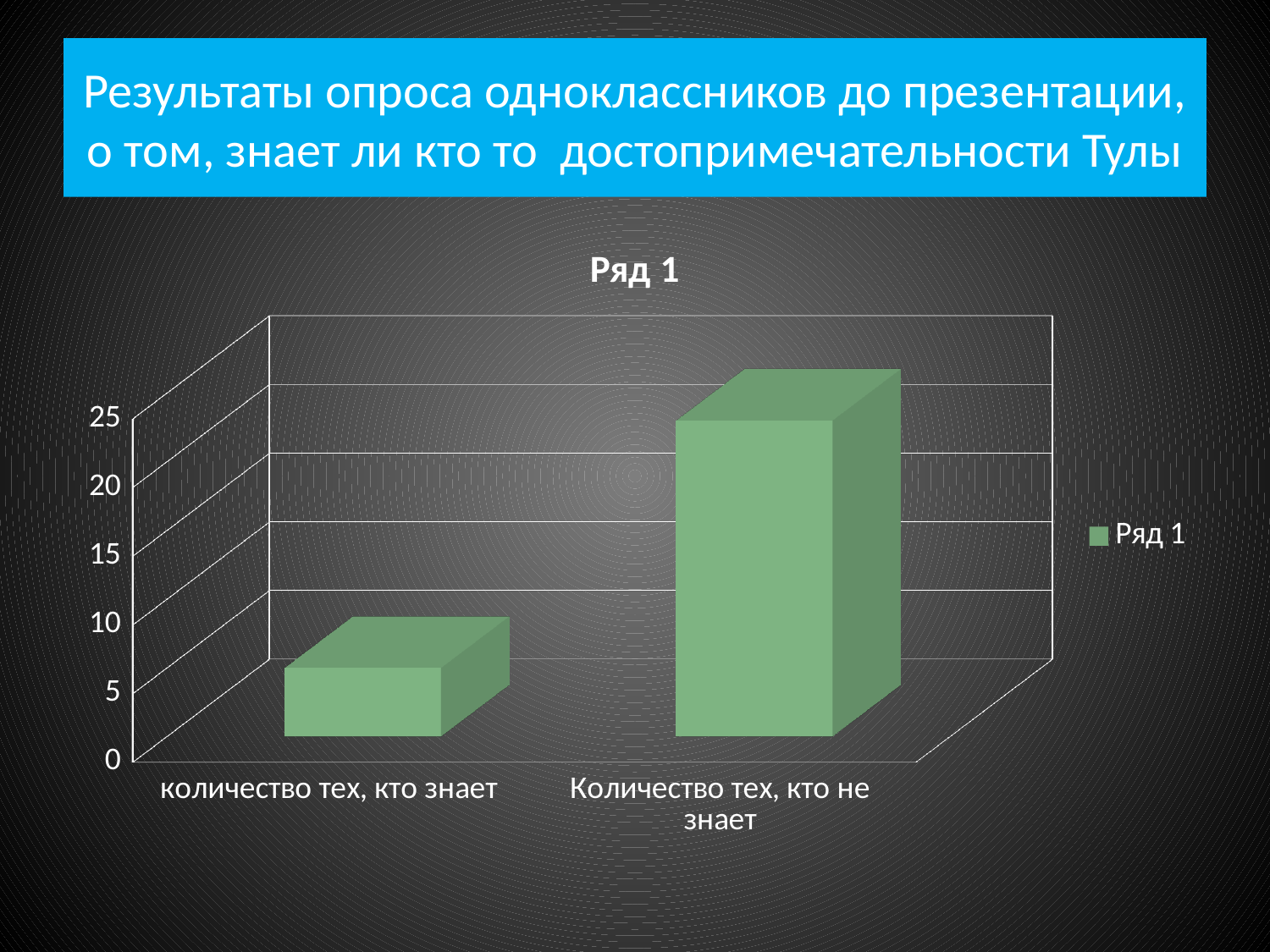
Which category has the highest value in the chart? Количество тех, кто не знает Is the value for "Количество тех, кто не знает" greater or less than 15? greater How many series does the chart legend list? 1 Is the value for "Количество тех, кто не знает" greater or less than 20? greater What is the highest value labelled on the vertical axis of the chart? 25 Is the value for "количество тех, кто знает" greater or less than 10? less Which is larger: the value for "количество тех, кто знает" or the value for "Количество тех, кто не знает"? Количество тех, кто не знает Do the values rise or fall from the first category to the second along the x axis? rise What is the title of the chart? Ряд 1 What kind of chart is shown on the slide? bar chart Which category has the lowest value in the chart? количество тех, кто знает How many categories are shown on the x axis of the chart? 2